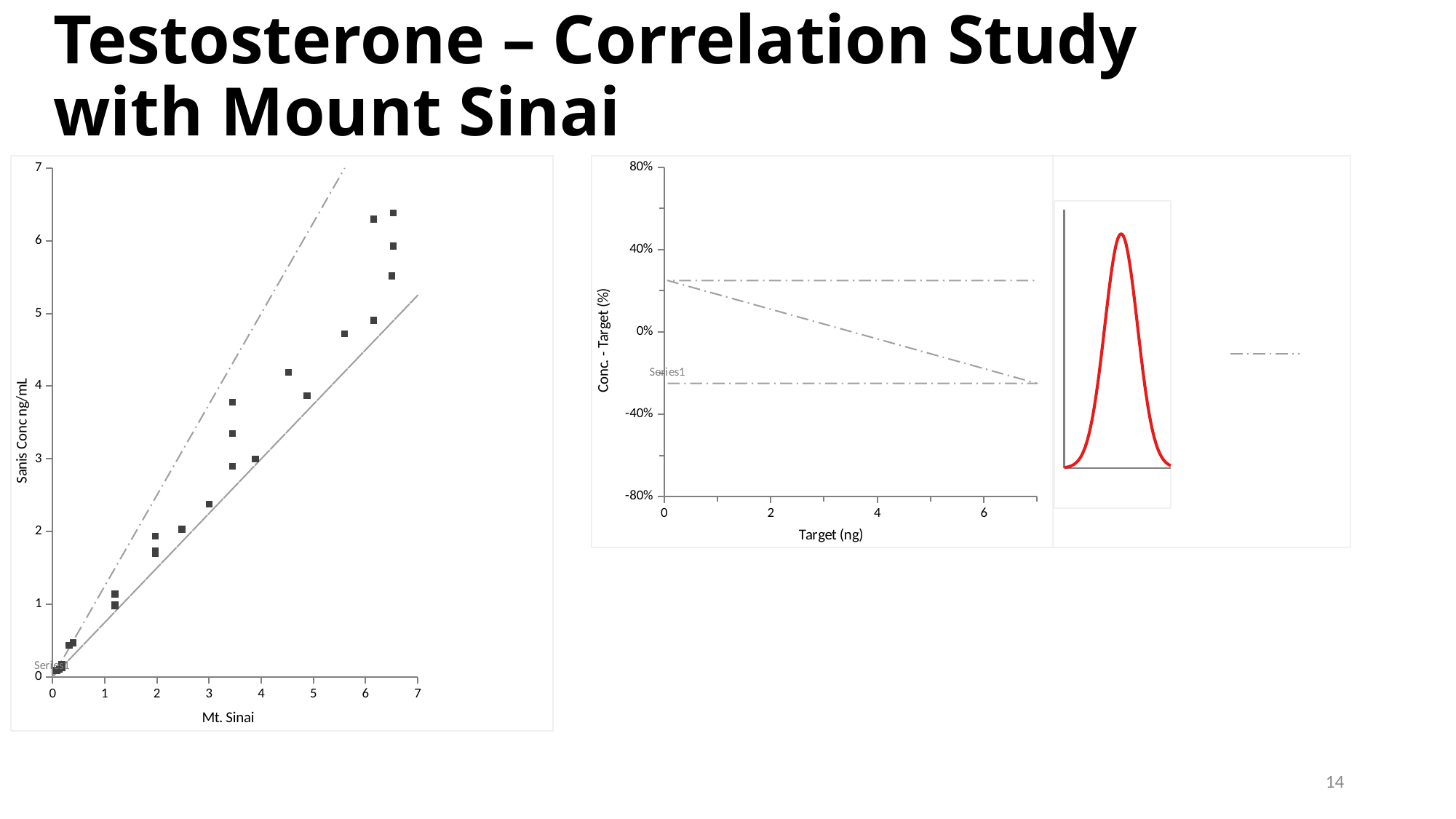
On the left chart, is the Sanis Conc value of the highest plotted point greater or less than 6? greater What kind of chart is the left chart with axes Mt. Sinai and Sanis Conc ng/mL? scatter chart On the right chart, what is the highest value shown on the y axis? 80% On the left chart, do the plotted points rise or fall as the Mt. Sinai value increases? rise On the right chart, is the upper horizontal dashed line greater or less than 0%? greater On the left chart, is the Sanis Conc value of the point at Mt. Sinai 3 greater or less than 3? less On the right chart, what is the lowest value shown on the y axis? -80% On the right chart, what is the title of the x axis? Target (ng) On the left chart, what is the highest value shown on the y axis? 7 On the left chart, what is the title of the y axis? Sanis Conc ng/mL On the left chart, what is the title of the x axis? Mt. Sinai